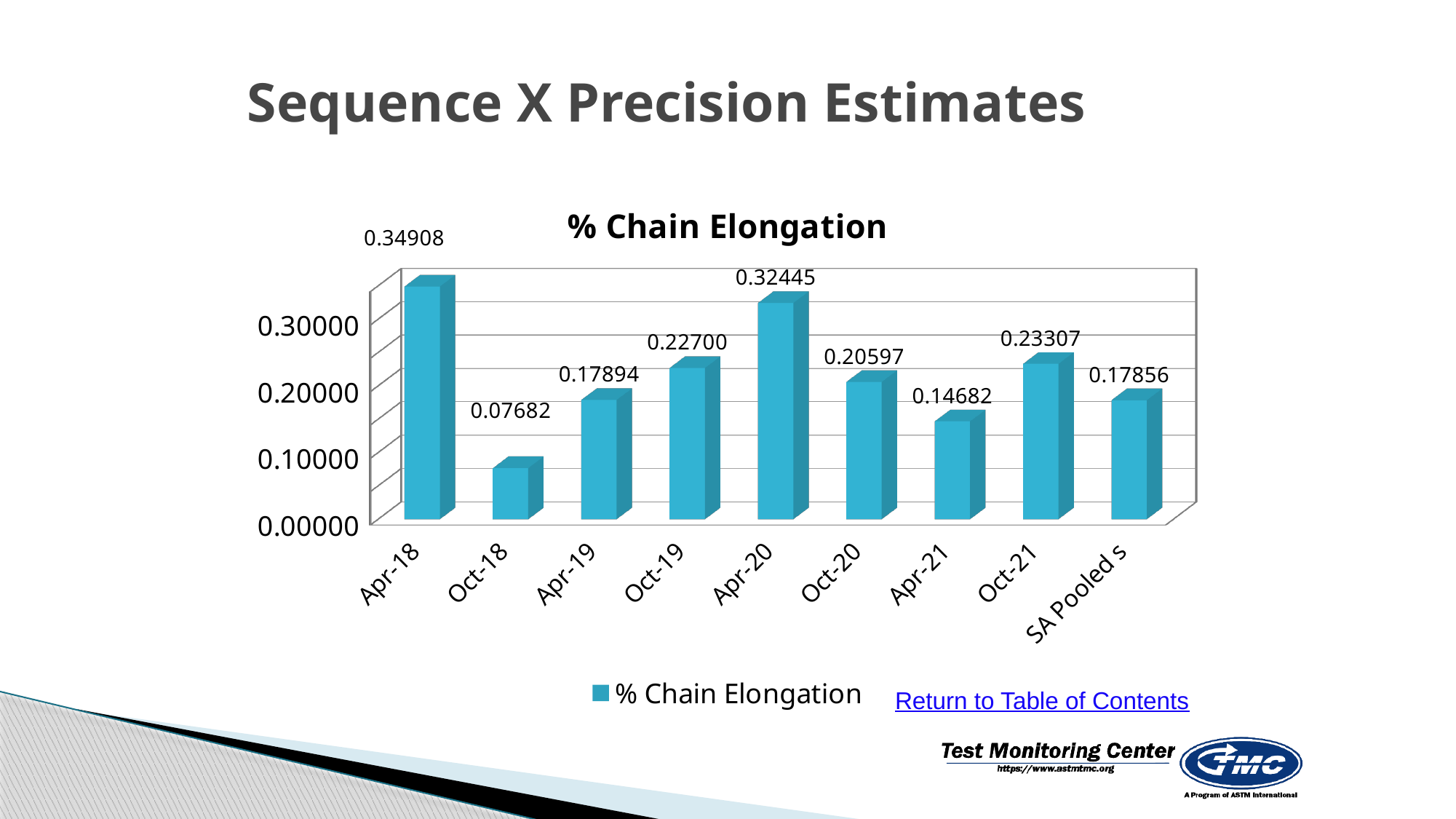
How many series does the legend of the % Chain Elongation chart list? 1 What is the % Chain Elongation value for SA Pooled s? 0.17856 What kind of chart is the % Chain Elongation chart? Bar chart What is the difference between the % Chain Elongation values for Apr-18 and Oct-18? 0.27226 Which category has the highest % Chain Elongation? Apr-18 How many categories are shown on the x axis of the % Chain Elongation chart? 9 What is the % Chain Elongation value for Apr-21? 0.14682 What is the difference between the % Chain Elongation values for Apr-20 and Oct-20? 0.11848 What is the % Chain Elongation value for Oct-18? 0.07682 Which category has the lowest % Chain Elongation? Oct-18 What is the % Chain Elongation value for Apr-18? 0.34908 Which has a larger % Chain Elongation, Apr-20 or Oct-20? Apr-20